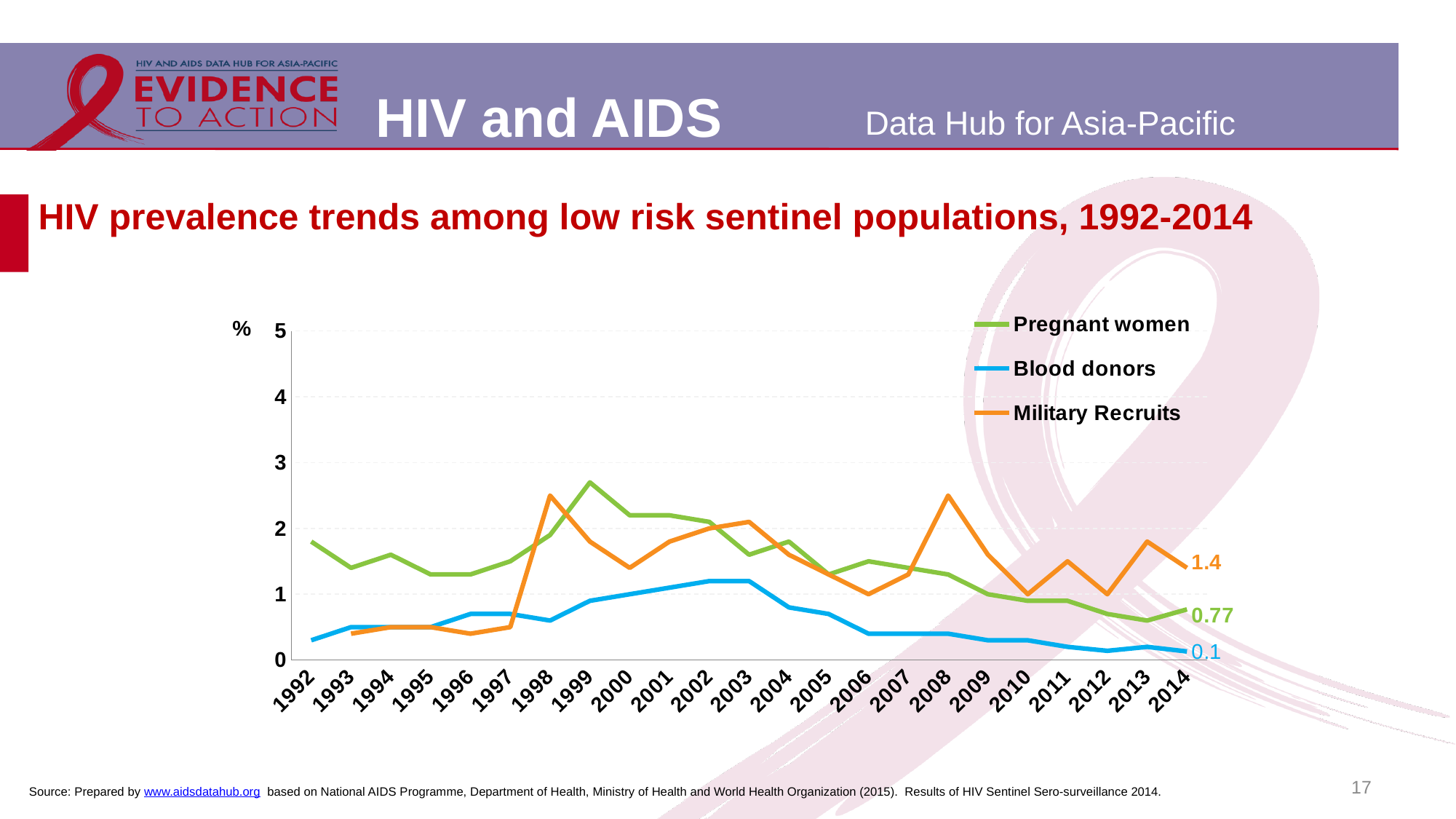
How many series does the legend list? 3 What is the value for Pregnant women in 2014? 0.77 What is the value for Blood donors in 2014? 0.1 Which series has the highest value in 2014? Military Recruits Which colour is used for the Military Recruits line? Orange What is the difference between the Military Recruits and Pregnant women values in 2014? 0.63 What kind of chart is shown on the slide? Line chart Which series has the lowest value in 2014? Blood donors How many years are shown on the x axis? 23 What is the value for Military Recruits in 2014? 1.4 Is the value for Pregnant women in 1999 greater or less than 2? greater Does the Blood donors line rise or fall from 2003 to 2014? Fall